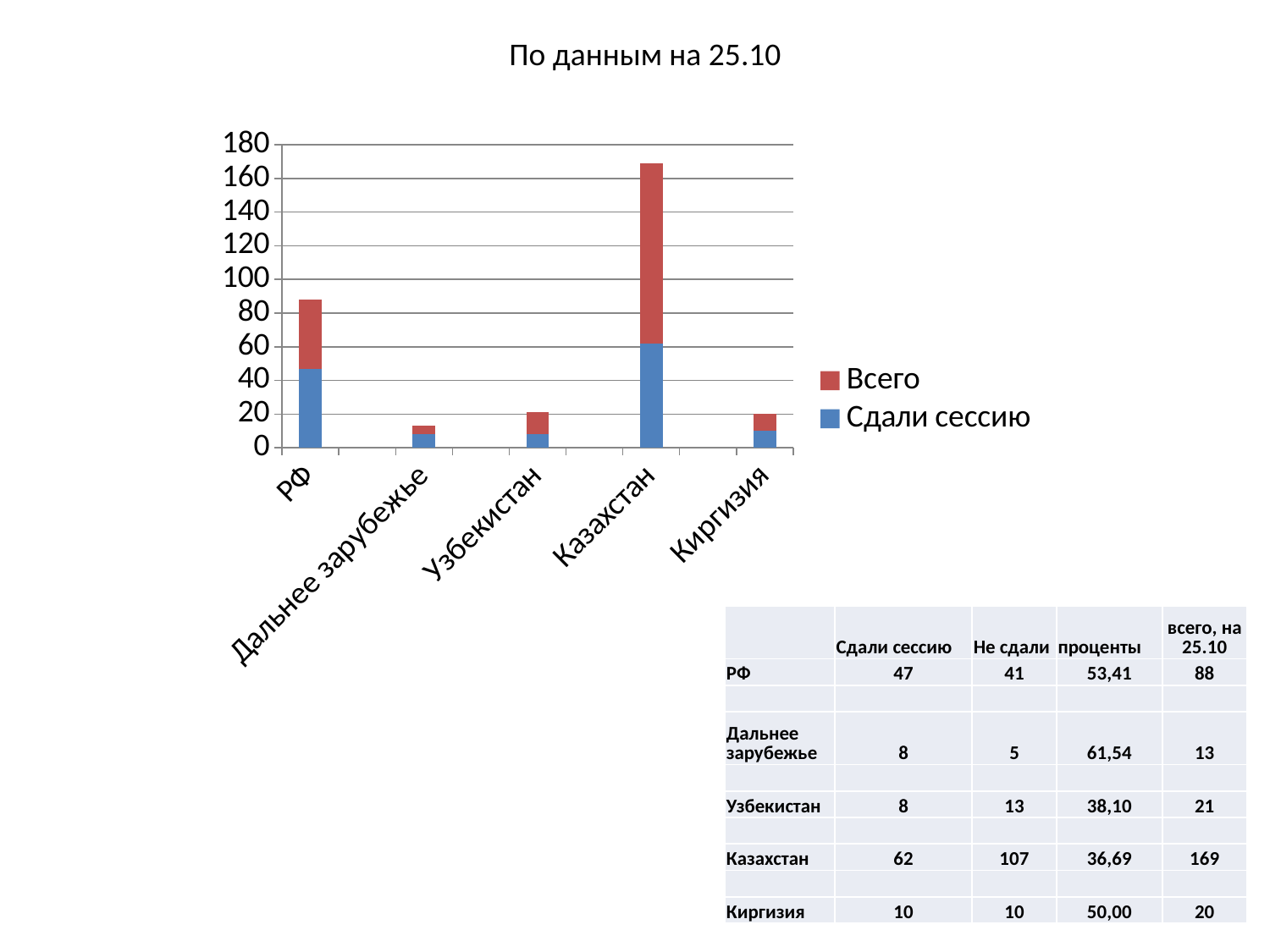
Which category has the tallest stacked bar? Казахстан Is the top of the stacked bar for РФ greater or less than 100? less Which stacked bar is taller, РФ or Казахстан? Казахстан How many categories are shown on the x axis of the chart? 5 Which category has the shortest stacked bar? Дальнее зарубежье Which colour represents the Сдали сессию series in the chart? blue Is the Сдали сессию value for РФ greater or less than 40? greater Which stacked bar is taller, Узбекистан or Дальнее зарубежье? Узбекистан What is the title of the chart? По данным на 25.10 How many series does the chart legend list? 2 Is the top of the stacked bar for Казахстан greater or less than 160? greater What kind of chart is shown on the slide? stacked bar chart